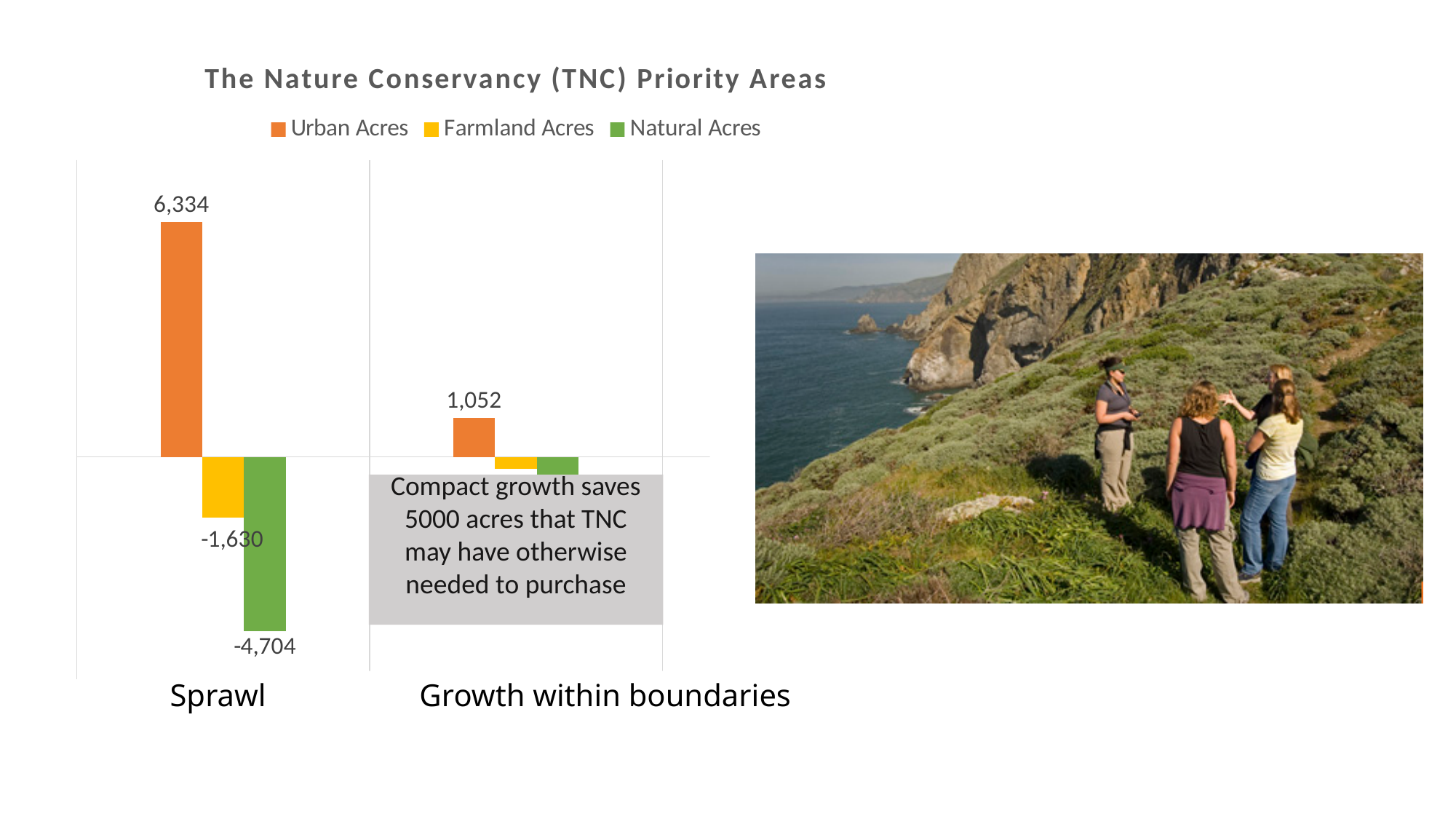
What is the value of Urban Acres for Sprawl? 6,334 What kind of chart is shown on the slide? Bar chart Which is larger, the Urban Acres value for Sprawl or for Growth within boundaries? Sprawl What is the title of the chart? The Nature Conservancy (TNC) Priority Areas What is the value of Natural Acres for Sprawl? -4,704 How many categories are shown on the x axis? 2 What is the value of Farmland Acres for Sprawl? -1,630 How many series does the legend list? 3 Which bar in the chart has the highest value? Urban Acres for Sprawl How much larger is the Urban Acres value for Sprawl than for Growth within boundaries? 5,282 What is the value of Urban Acres for Growth within boundaries? 1,052 Which series has the lowest value for Sprawl? Natural Acres